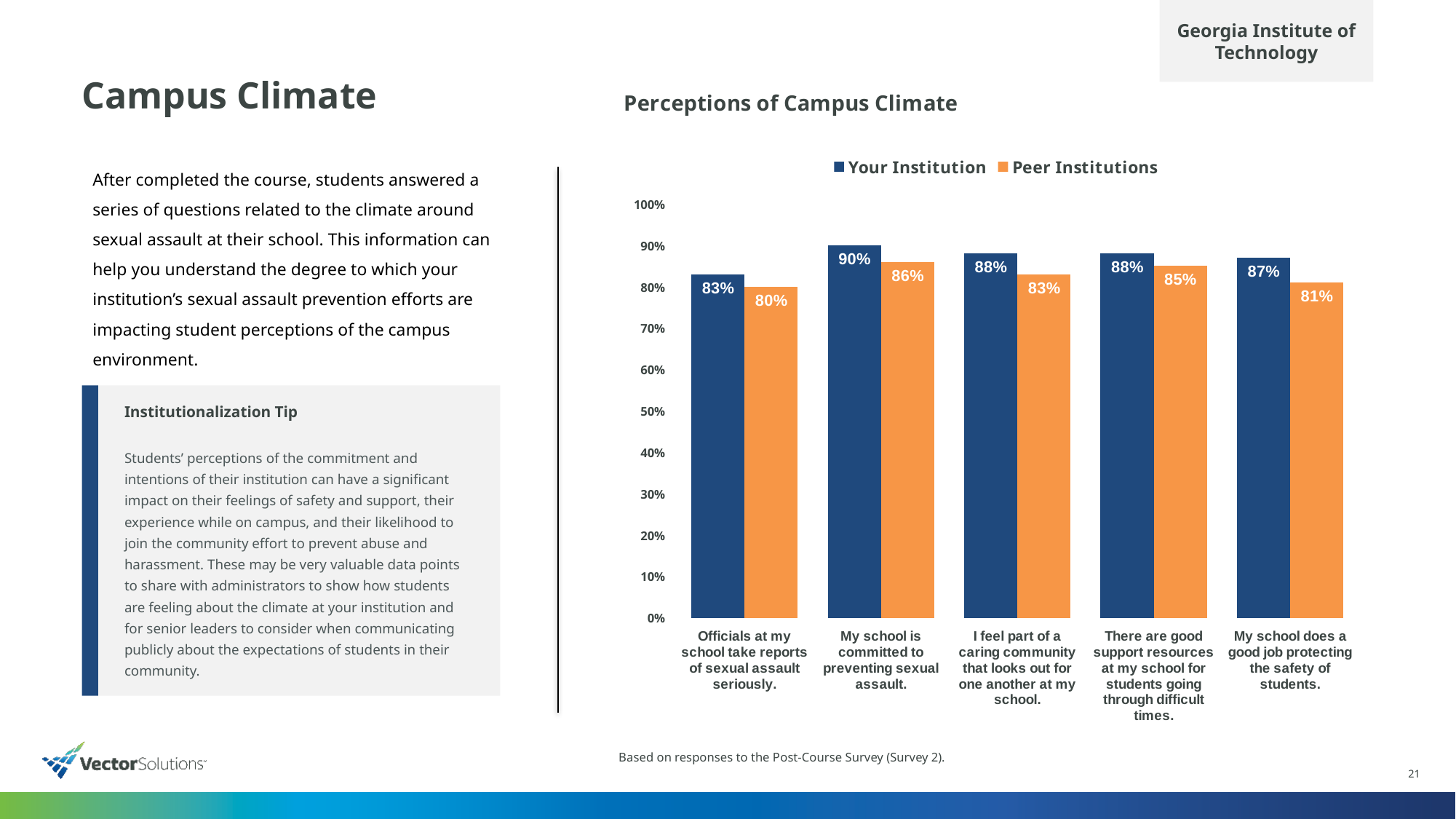
Which category has the lowest Peer Institutions value? Officials at my school take reports of sexual assault seriously. How many categories are shown on the x axis of the chart? 5 What is the difference between the Your Institution and Peer Institutions values for "My school does a good job protecting the safety of students."? 6% What is the Peer Institutions value for "Officials at my school take reports of sexual assault seriously."? 80% What is the Peer Institutions value for "My school does a good job protecting the safety of students."? 81% How many series does the legend list? 2 What is the Your Institution value for "My school is committed to preventing sexual assault."? 90% What is the title of the chart? Perceptions of Campus Climate Is the Peer Institutions value for "There are good support resources at my school for students going through difficult times." greater or less than 80%? greater What kind of chart is shown on the slide? Bar chart Which category has the highest Your Institution value? My school is committed to preventing sexual assault. For "I feel part of a caring community that looks out for one another at my school.", which is larger: Your Institution or Peer Institutions? Your Institution